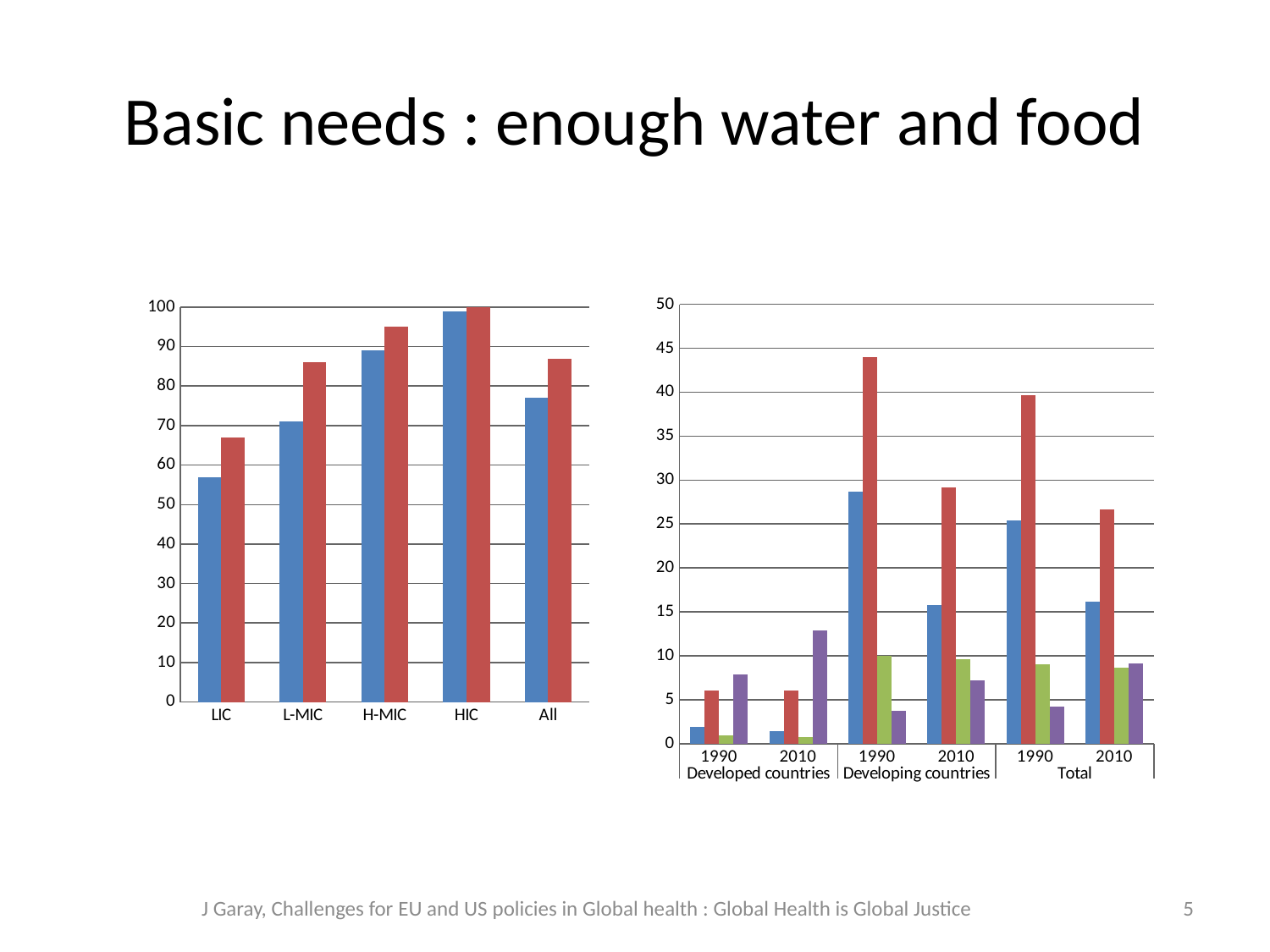
How many country groups are labelled on the x axis of the right chart? 3 In the right chart, is the red bar for Developing countries in 1990 greater or less than 40? greater What kind of chart is the chart on the left of the slide? bar chart In the left chart, which is larger for H-MIC, the blue bar or the red bar? the red bar In the left chart, is the blue bar for LIC greater or less than 60? less In the left chart, is the red bar for L-MIC greater or less than 80? greater In the left chart, which category has the highest red bar? HIC In the left chart, which category has the lowest blue bar? LIC How many categories are shown on the x axis of the left chart? 5 In the left chart, do the blue bars rise or fall from LIC to HIC? rise In the right chart, which is larger for Total in 2010, the blue bar or the red bar? the red bar